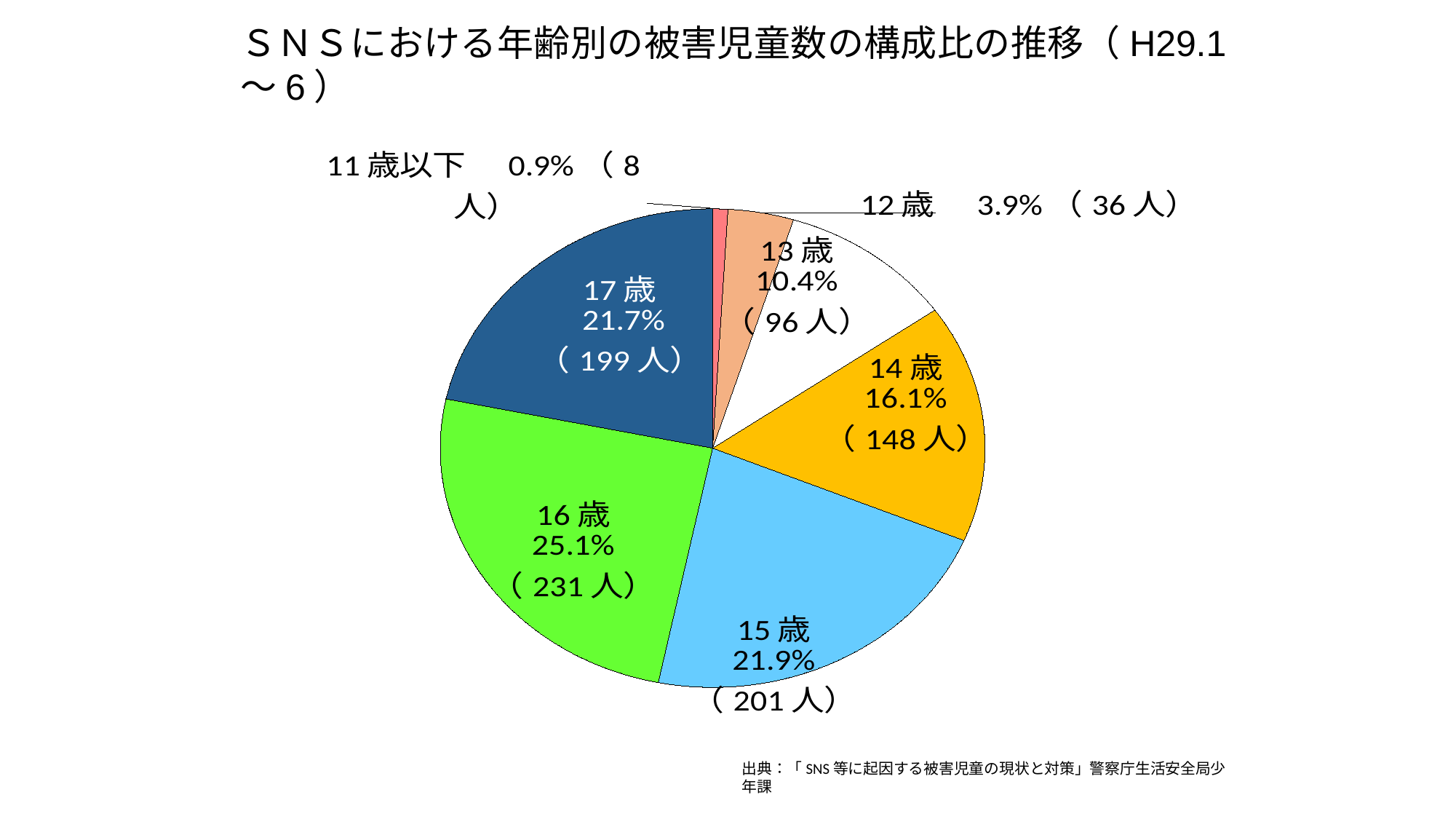
How many victims (人) are shown for 14歳? 148人 Which age category has the largest share of the pie? 16歳 How many victims are shown for 12歳? 36人 What share of the pie does the 16歳 slice represent? 25.1% Which has more victims, 15歳 or 17歳? 15歳 Which age category has the smallest share of the pie? 11歳以下 What kind of chart is shown on the slide? pie chart How many age categories does the pie chart show? 7 What percentage is shown for 13歳? 10.4% What is the total number of victims across all age categories shown? 919人 What colour is the 16歳 slice of the pie? green What is the difference in the number of victims between 16歳 and 17歳? 32人